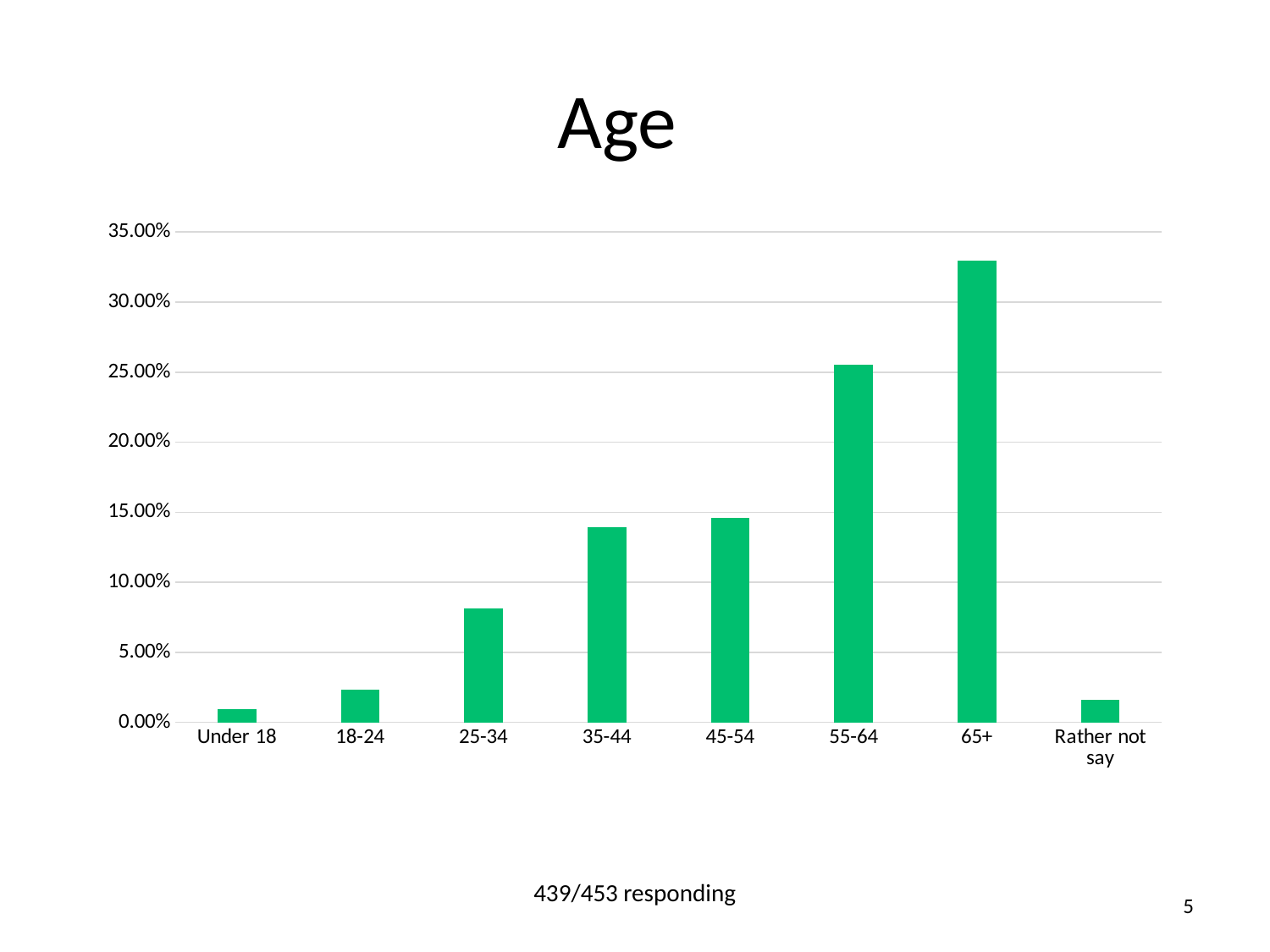
How many age categories are shown on the x axis? 8 Which is larger, the value for Rather not say or the value for 25-34? 25-34 Is the value for 35-44 greater or less than 15.00%? less Is the value for 65+ greater or less than 30.00%? greater Is the value for 25-34 greater or less than 10.00%? less Which category has the highest value? 65+ Which category has the lowest value? Under 18 What kind of chart is shown on the slide? bar chart What is the title of the chart? Age Which is larger, the value for 45-54 or the value for 35-44? 45-54